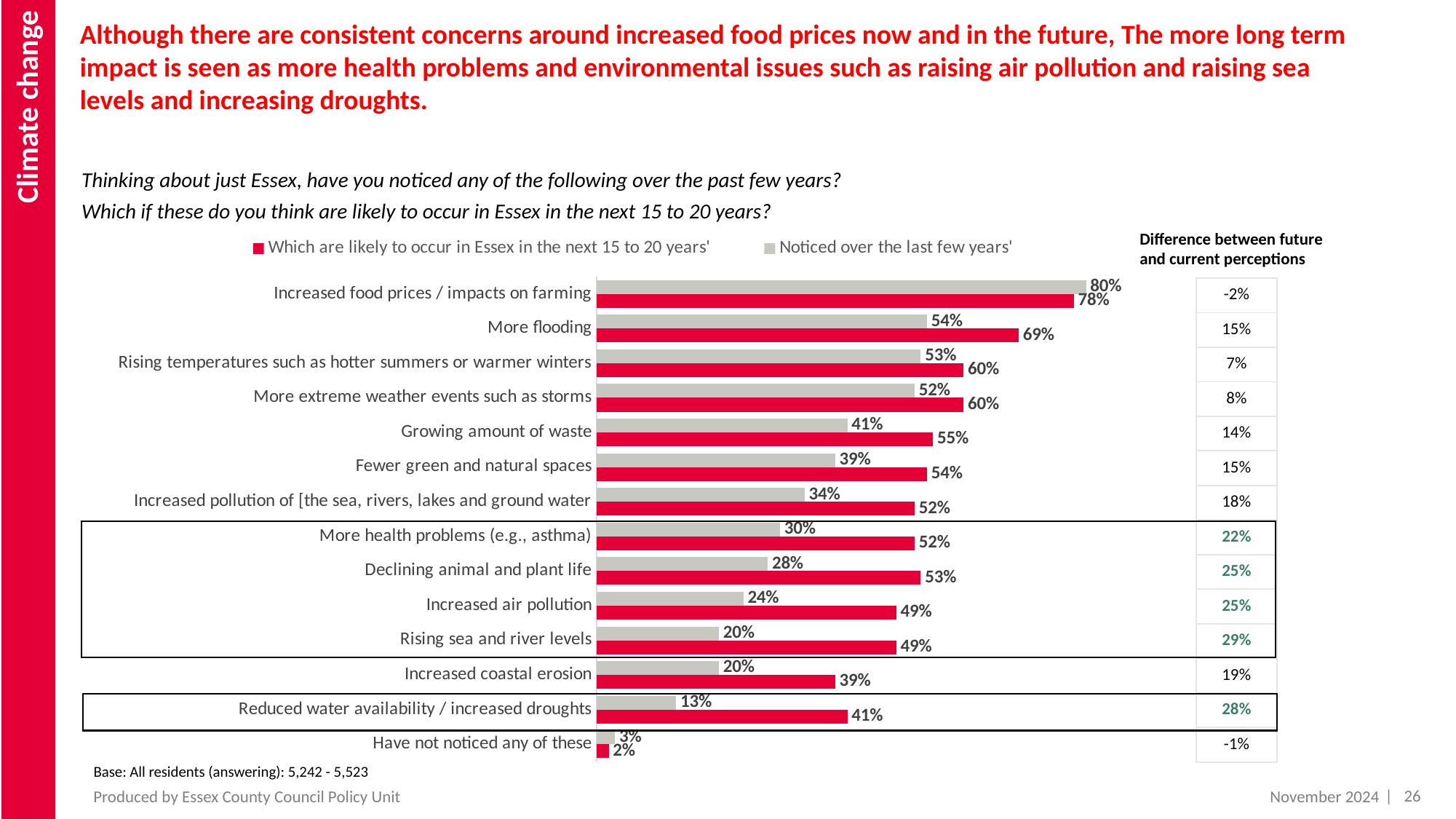
Which is larger for increased coastal erosion: the value noticed over the last few years or the value likely to occur in the next 15 to 20 years? Likely to occur in the next 15 to 20 years What is the difference between the future and current values for rising sea and river levels? 29% What percentage think more flooding is likely to occur in Essex in the next 15 to 20 years? 69% How many series does the legend list? 2 What type of chart is shown on the slide? Bar chart Which category has the highest value for 'Noticed over the last few years'? Increased food prices / impacts on farming Which colour represents 'Noticed over the last few years' in the chart? Grey What is the total of the two values shown for more health problems (e.g., asthma)? 82% What percentage noticed reduced water availability / increased droughts over the last few years? 13% How many categories are shown in the chart? 14 What percentage of respondents noticed increased food prices / impacts on farming over the last few years? 80% Which category has the lowest value for 'Which are likely to occur in Essex in the next 15 to 20 years'? Have not noticed any of these